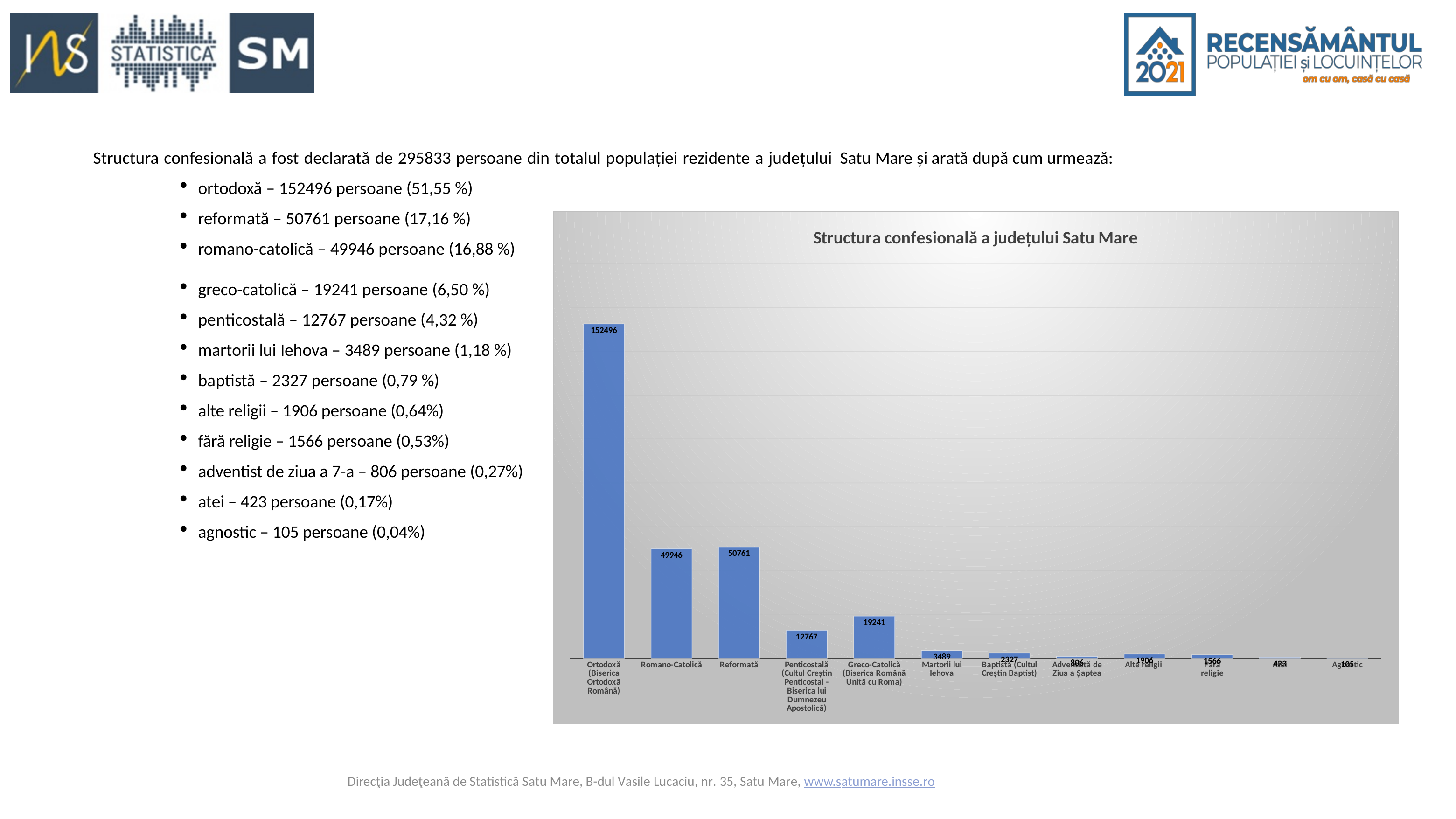
Which category has the highest value? Ortodoxă (Biserica Ortodoxă Română) What is the value for Ortodoxă (Biserica Ortodoxă Română)? 152496 What is the title of the chart? Structura confesională a județului Satu Mare Which category has the lowest value? Agnostic Which is larger, the value for Greco-Catolică or the value for Penticostală? Greco-Catolică What is the value for Reformată? 50761 What is the difference between the values for Reformată and Romano-Catolică? 815 What is the value for Greco-Catolică (Biserica Română Unită cu Roma)? 19241 What is the difference between the values for Ortodoxă and Reformată? 101735 What is the value for Martorii lui Iehova? 3489 What type of chart is shown on the slide? bar chart How many categories are plotted in the chart? 12